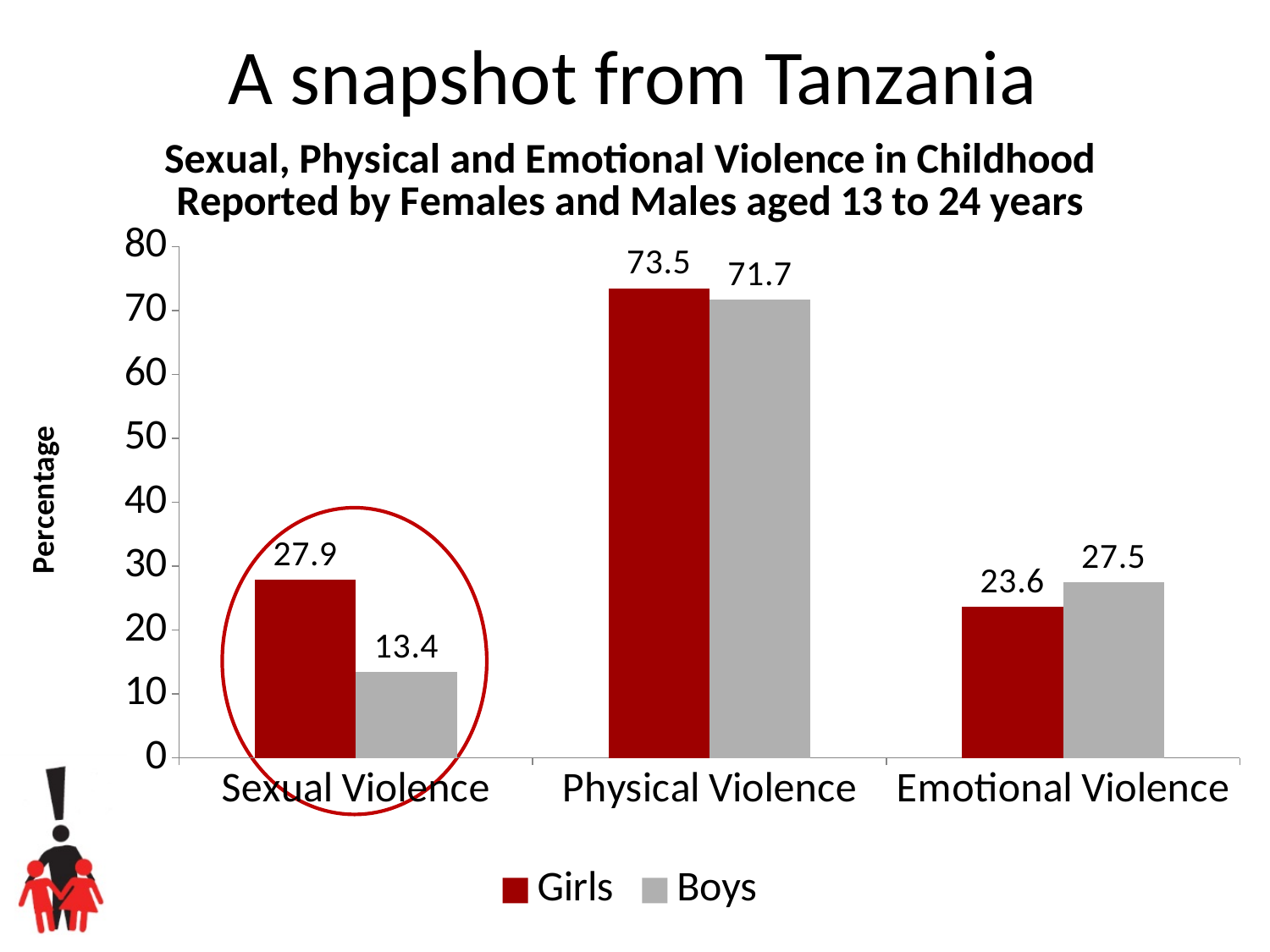
What kind of chart is shown on the slide? Bar chart Which category has the lowest value for Boys? Sexual Violence For Emotional Violence, which is larger, the Girls value or the Boys value? Boys What is the difference between the Girls and Boys values for Sexual Violence? 14.5 What is the value for Girls for Sexual Violence? 27.9 Which category has the highest value for Girls? Physical Violence Is the value for Girls for Physical Violence greater or less than 70? greater What is the value for Girls for Emotional Violence? 23.6 How many categories are shown on the x axis? 3 How many series does the legend list? 2 What is the value for Boys for Physical Violence? 71.7 What is the value for Boys for Sexual Violence? 13.4